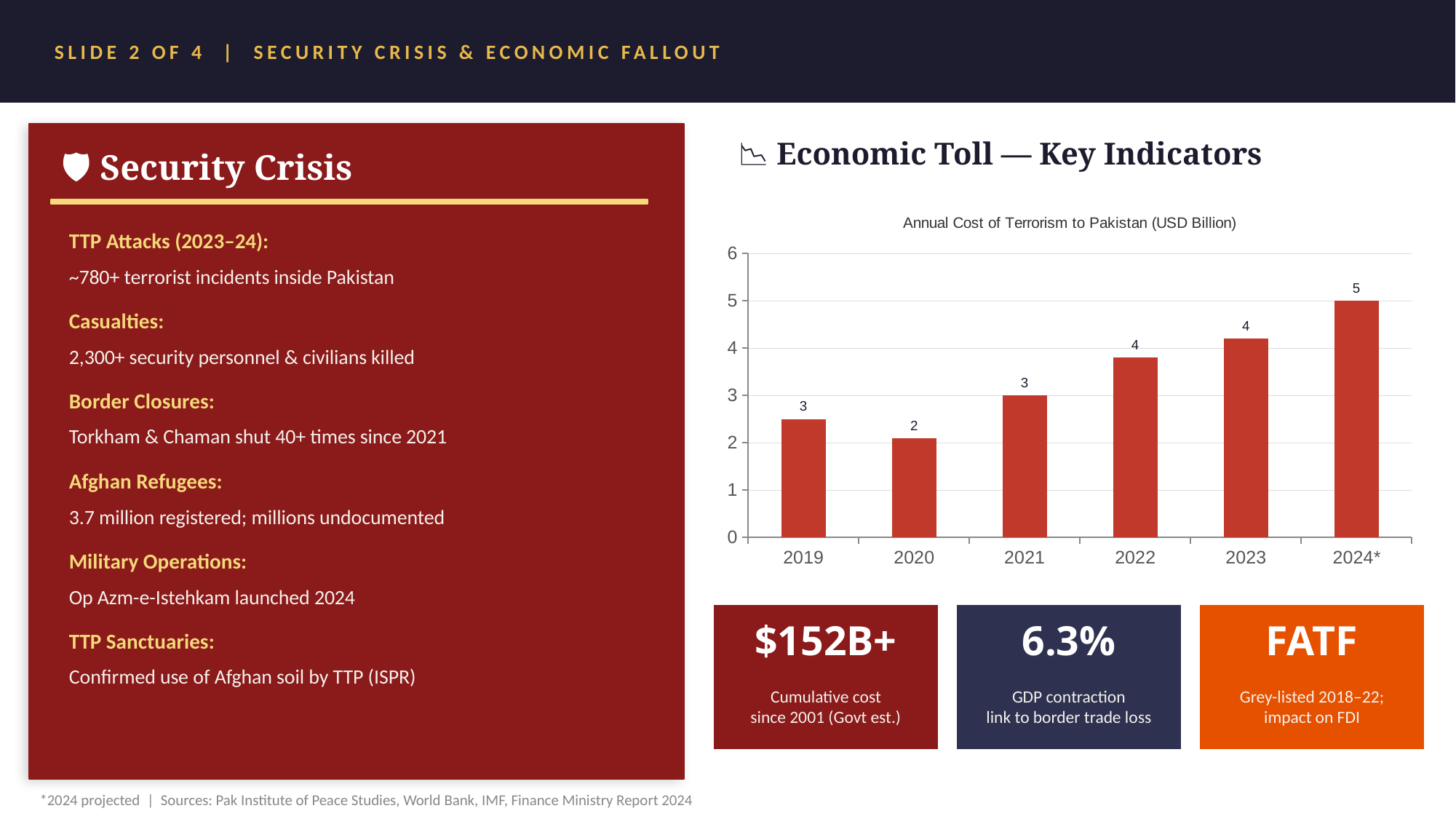
How many years are shown on the x axis of the chart? 6 What is the data label shown for 2021 in the chart? 3 What is the data label shown for 2024* in the chart? 5 Which year has the lowest annual cost of terrorism in the chart? 2020 Is the value for 2020 in the chart greater or less than 3? less What kind of chart is used to show the annual cost of terrorism? bar chart Is the value for 2022 in the chart greater or less than 3? greater Do the values in the chart generally rise or fall from 2020 to 2024*? rise Which year shows a higher value in the chart, 2021 or 2023? 2023 What is the data label shown for 2020 in the chart? 2 What is the title of the chart? Annual Cost of Terrorism to Pakistan (USD Billion) Which year has the highest annual cost of terrorism in the chart? 2024*